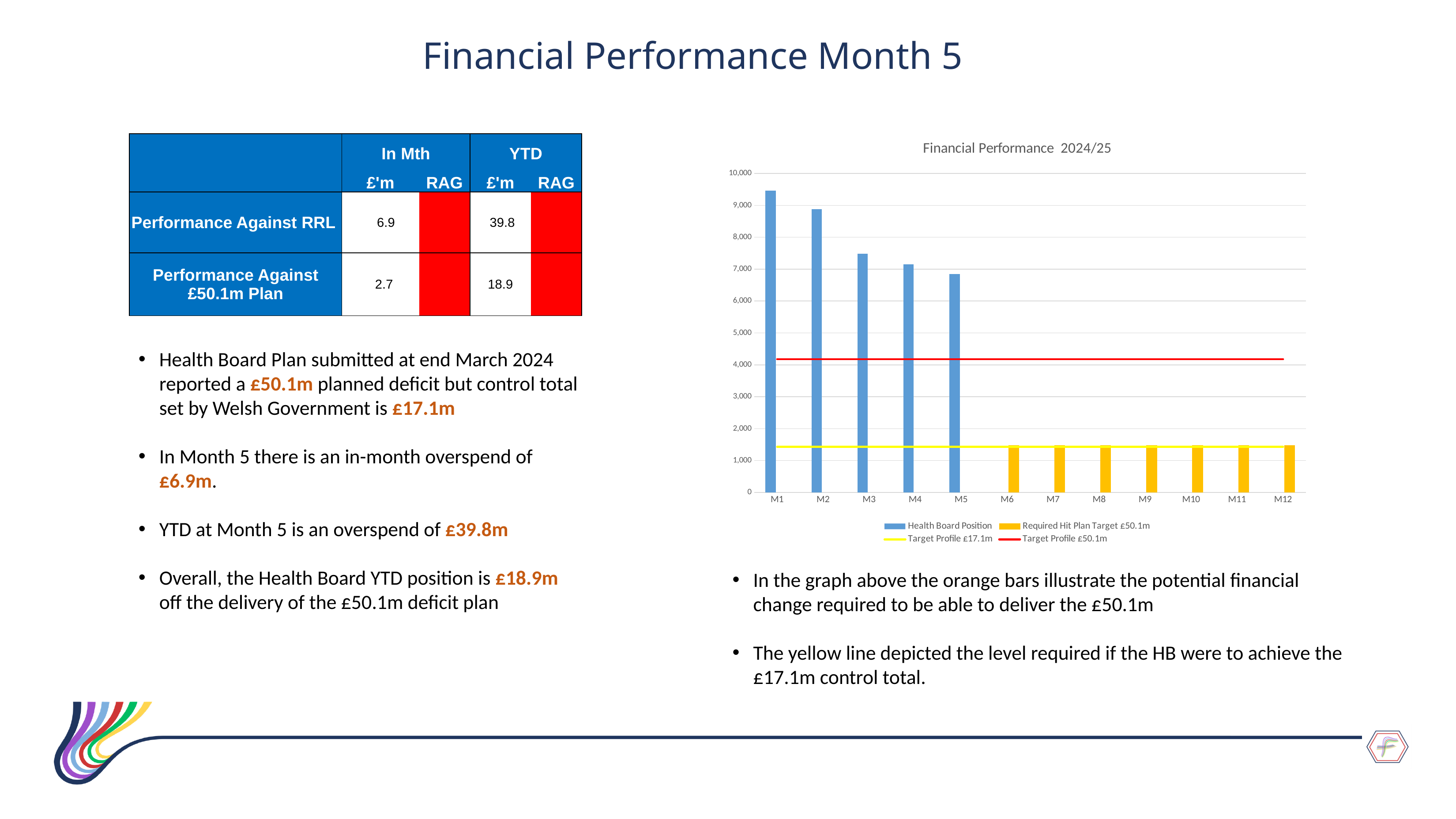
Do the Health Board Position bars rise or fall from M1 to M5? fall Which legend entry is shown as a yellow line? Target Profile £17.1m Which is larger, the Health Board Position bar for M2 or for M4? M2 Is the Health Board Position value for M5 greater or less than 7,000? less Is the Health Board Position value for M3 greater or less than 7,000? greater Which month has the highest Health Board Position bar? M1 How many month categories are shown on the x axis of the chart? 12 What is the title of the chart? Financial Performance 2024/25 Is the Health Board Position value for M1 greater or less than 9,000? greater What kind of chart is shown on the slide? combination bar and line chart How many series does the chart legend list? 4